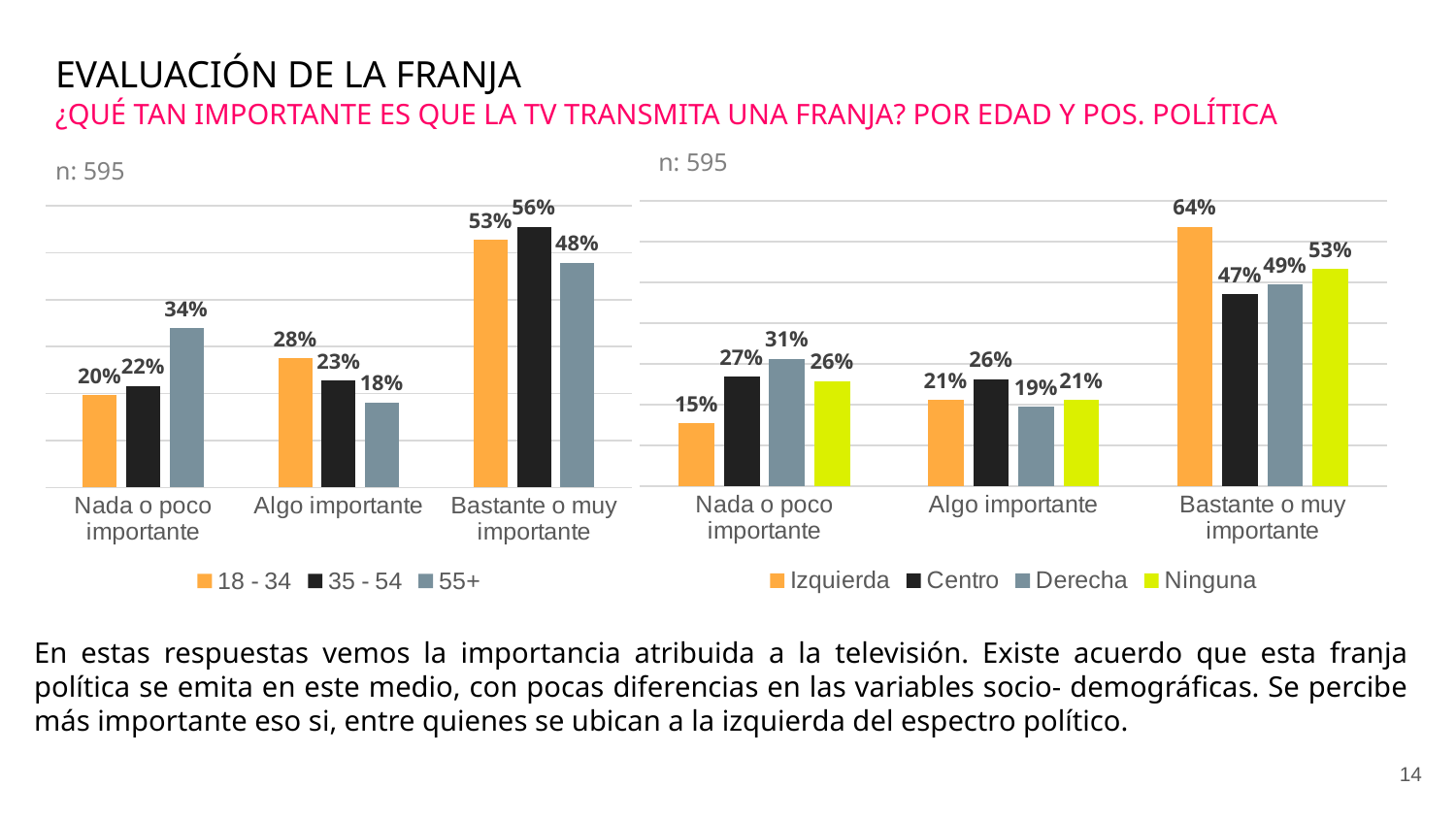
What kind of chart is the left chart? Bar chart In the left chart, what is the value for 35 - 54 in the 'Bastante o muy importante' category? 56% In the left chart, which is larger in the 'Nada o poco importante' category: 18 - 34 or 55+? 55+ What sample size (n) is shown above the left chart? n: 595 In the right chart, which series has the highest value in the 'Bastante o muy importante' category? Izquierda How many categories are shown on the x axis of the left chart? 3 In the left chart, what is the value for 55+ in the 'Nada o poco importante' category? 34% How many series does the legend of the right chart list? 4 In the right chart, what is the value for Izquierda in the 'Bastante o muy importante' category? 64% In the left chart, which series has the lowest value in the 'Algo importante' category? 55+ In the right chart, what is the difference between Izquierda and Centro in the 'Bastante o muy importante' category? 17% In the right chart, what is the value for Derecha in the 'Nada o poco importante' category? 31%